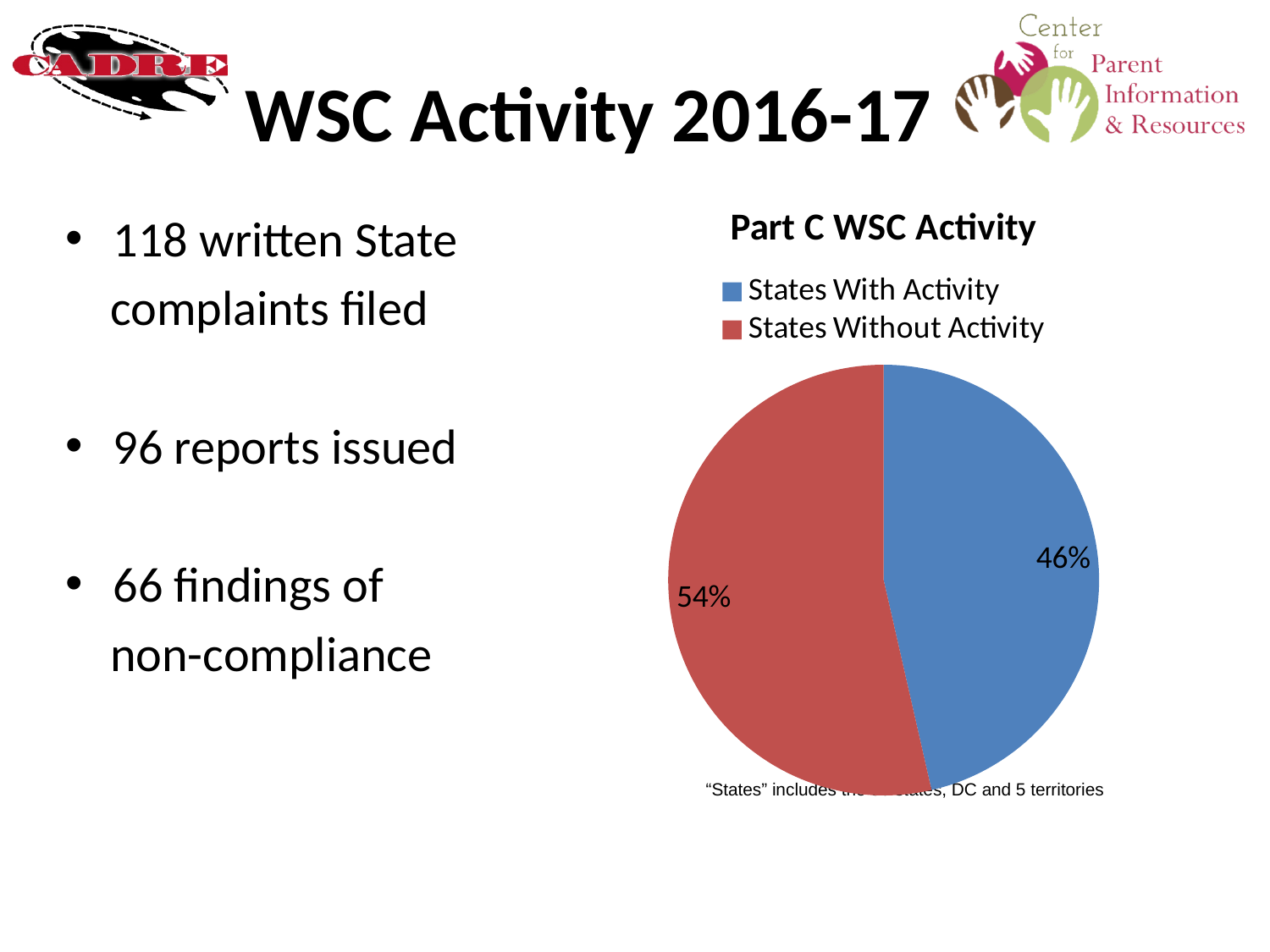
What is the difference in percentage points between States Without Activity and States With Activity? 8 How many slices does the pie chart have? 2 What is the title of the chart? Part C WSC Activity How many entries does the legend list? 2 What percentage of the pie is labelled for States With Activity? 46% What share of the pie does the States With Activity slice represent? 46% Which is larger, the share for States With Activity or the share for States Without Activity? States Without Activity Which slice of the pie is the smallest? States With Activity What percentage of the pie is labelled for States Without Activity? 54% What colour is the slice for States With Activity? blue Which slice of the pie is the largest? States Without Activity What kind of chart is shown on the slide? pie chart